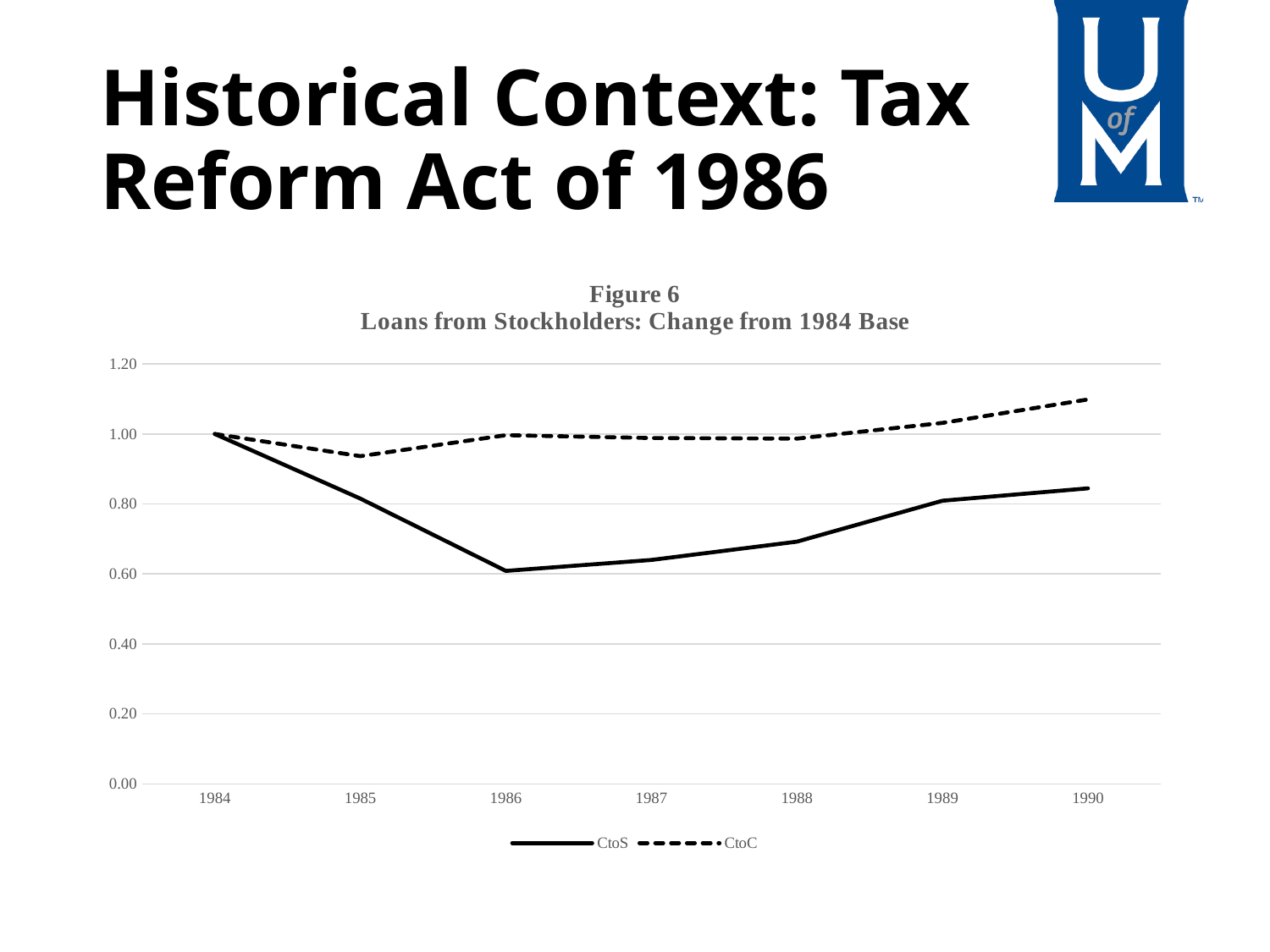
Is the value for CtoS in 1986 greater or less than 0.80? less How many years are plotted along the x axis? 7 Is the value for CtoC in 1990 greater or less than 1.00? greater Does the CtoS series rise or fall from 1984 to 1986? fall What is the value of CtoS in 1984? 1.00 Does the CtoC series rise or fall from 1988 to 1990? rise In which year is the CtoC series at its highest? 1990 What kind of chart is shown on the slide? Line chart How many series does the legend list? 2 In 1986, which series has the larger value, CtoS or CtoC? CtoC Which series is drawn with a dashed line? CtoC In which year is the CtoS series at its lowest? 1986